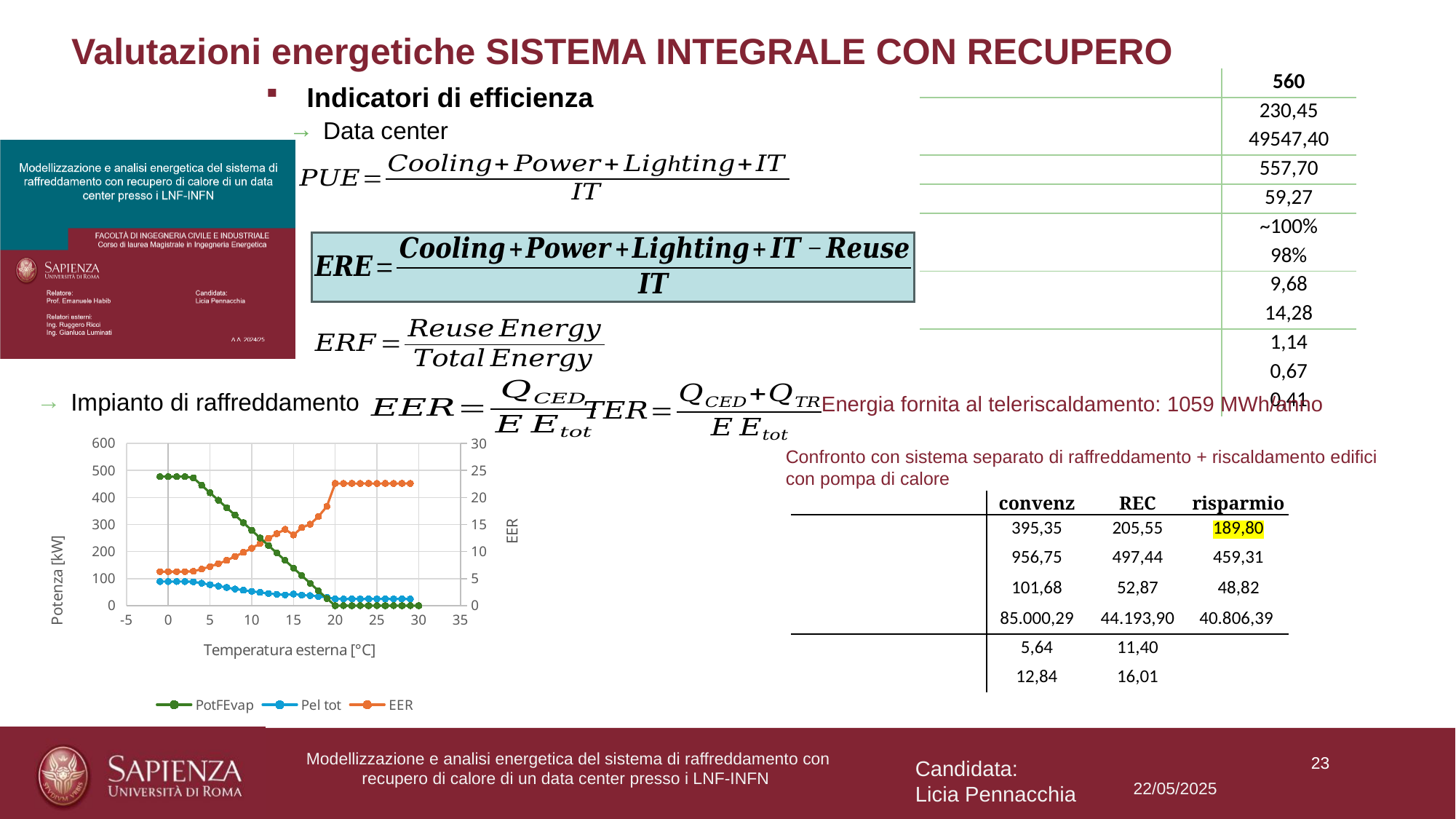
Does the Pel tot series rise or fall as the external temperature increases? fall Does the PotFEvap series rise or fall as the external temperature increases? fall Does the EER series rise or fall as the external temperature increases? rise What is the title of the chart's x axis? Temperatura esterna [°C] What kind of chart is shown on the slide? line chart Is the EER value at 25 °C greater or less than 20? greater At 5 °C, which is larger: PotFEvap or Pel tot? PotFEvap How many series does the chart legend list? 3 Is the PotFEvap value at 0 °C greater or less than 400 kW? greater Is the Pel tot value at 0 °C greater or less than 200 kW? less What are the series names listed in the chart legend? PotFEvap, Pel tot, EER